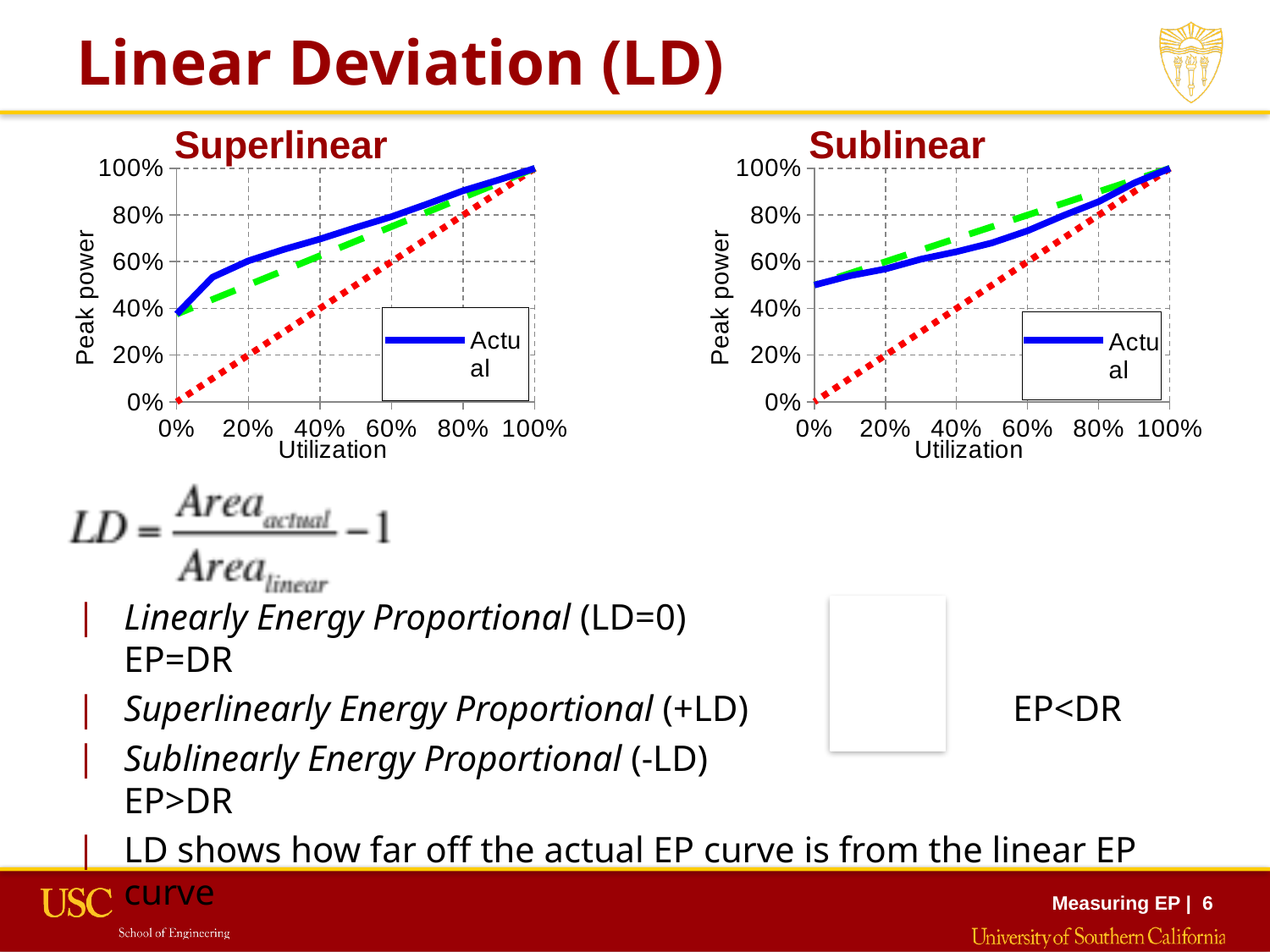
In the Superlinear chart, is the value of the Actual series at 0% utilization greater or less than 20%? greater What kind of chart is the Superlinear chart? line chart What is the y-axis label on the Sublinear chart? Peak power In the Sublinear chart, at 40% utilization, is the Actual series higher or lower than the red dotted line? higher In the Superlinear chart, is the value of the Actual series at 40% utilization greater or less than 60%? greater In the Sublinear chart, is the value of the Actual series at 0% utilization greater or less than 40%? greater In the Superlinear chart, what is the value of the Actual series at 100% utilization? 100% How many tick labels are shown on the x axis of the Sublinear chart? 6 In the Superlinear chart, does the Actual series rise or fall as utilization increases? rise In the Sublinear chart, what is the value of the Actual series at 100% utilization? 100% What is the title of the chart on the left side of the slide? Superlinear